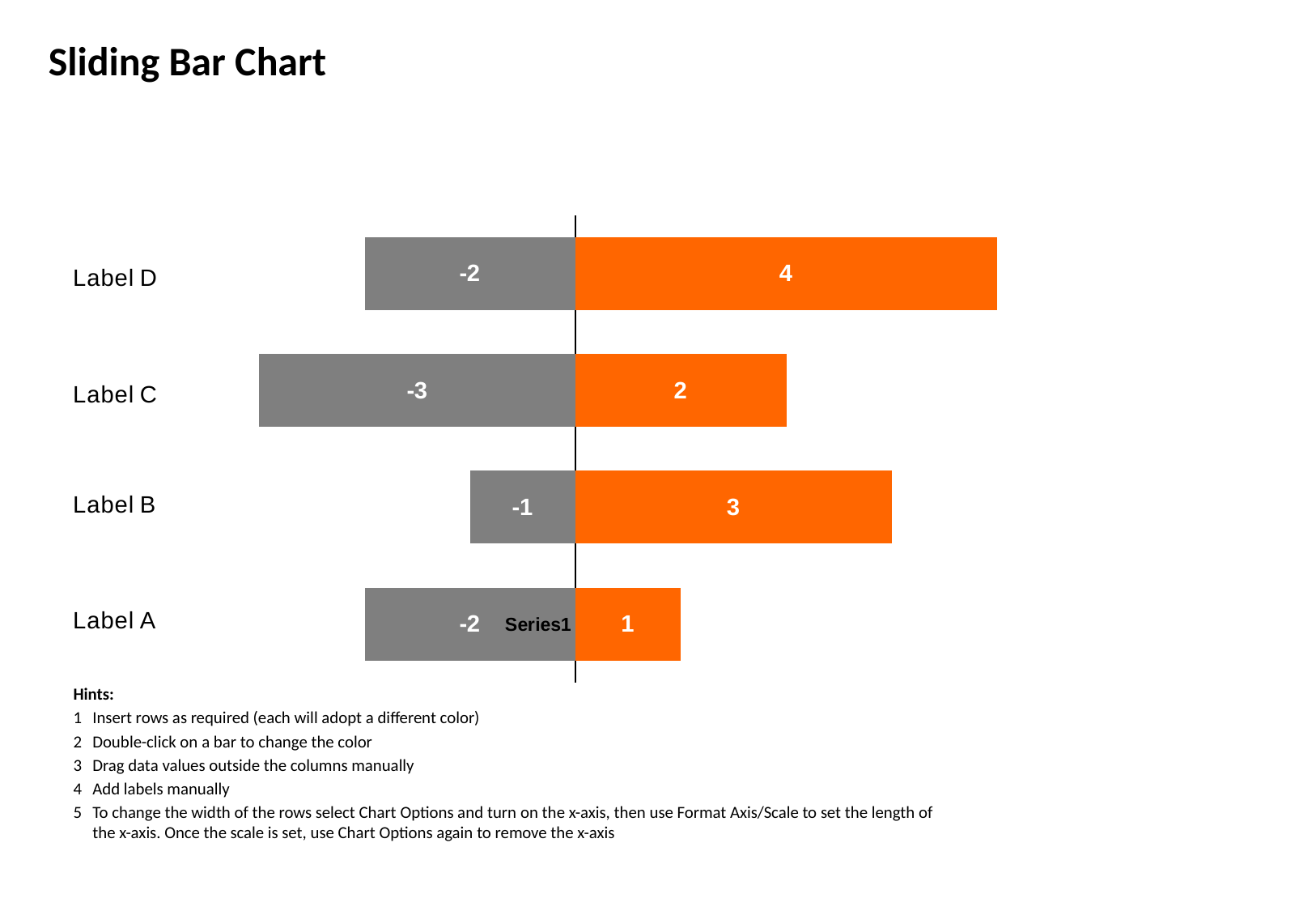
What kind of chart is shown on the slide? Bar chart What is the value of the gray bar for Label C? -3 How many categories are shown in the chart? 4 Which is larger, the orange bar value for Label B or for Label C? Label B Which category has the longest gray (negative) bar? Label C Which category has the lowest orange bar value? Label A What is the value of the gray bar for Label B? -1 What is the difference between the orange bar values for Label D and Label C? 2 What is the value of the orange bar for Label A? 1 Which category has the highest orange bar value? Label D What is the value of the orange bar for Label D? 4 What is the title of the slide containing the chart? Sliding Bar Chart